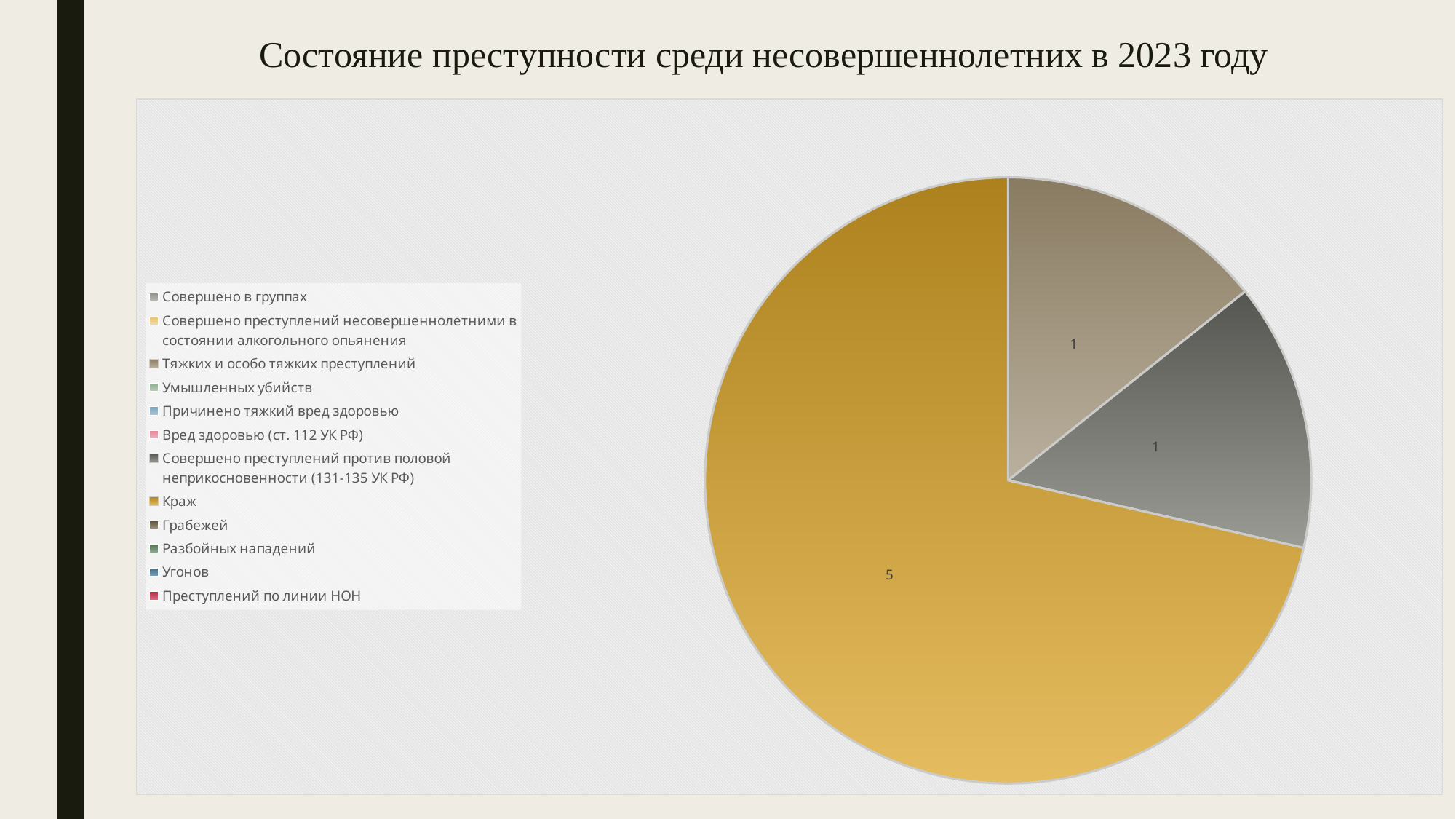
Which category has the largest slice of the pie? Краж How many entries does the legend list? 12 What is the title of the slide? Состояние преступности среди несовершеннолетних в 2023 году What is the value shown for the Тяжких и особо тяжких преступлений slice? 1 What is the value shown for the Краж slice? 5 How many slices with data labels are visible in the pie? 3 What is the value shown for the Совершено преступлений против половой неприкосновенности (131-135 УК РФ) slice? 1 What is the difference between the value for Краж and the value for Тяжких и особо тяжких преступлений? 4 What is the total of the three labelled slices in the pie? 7 What type of chart is shown on the slide? pie chart Which is larger: the value for Краж or the value for Тяжких и особо тяжких преступлений? Краж